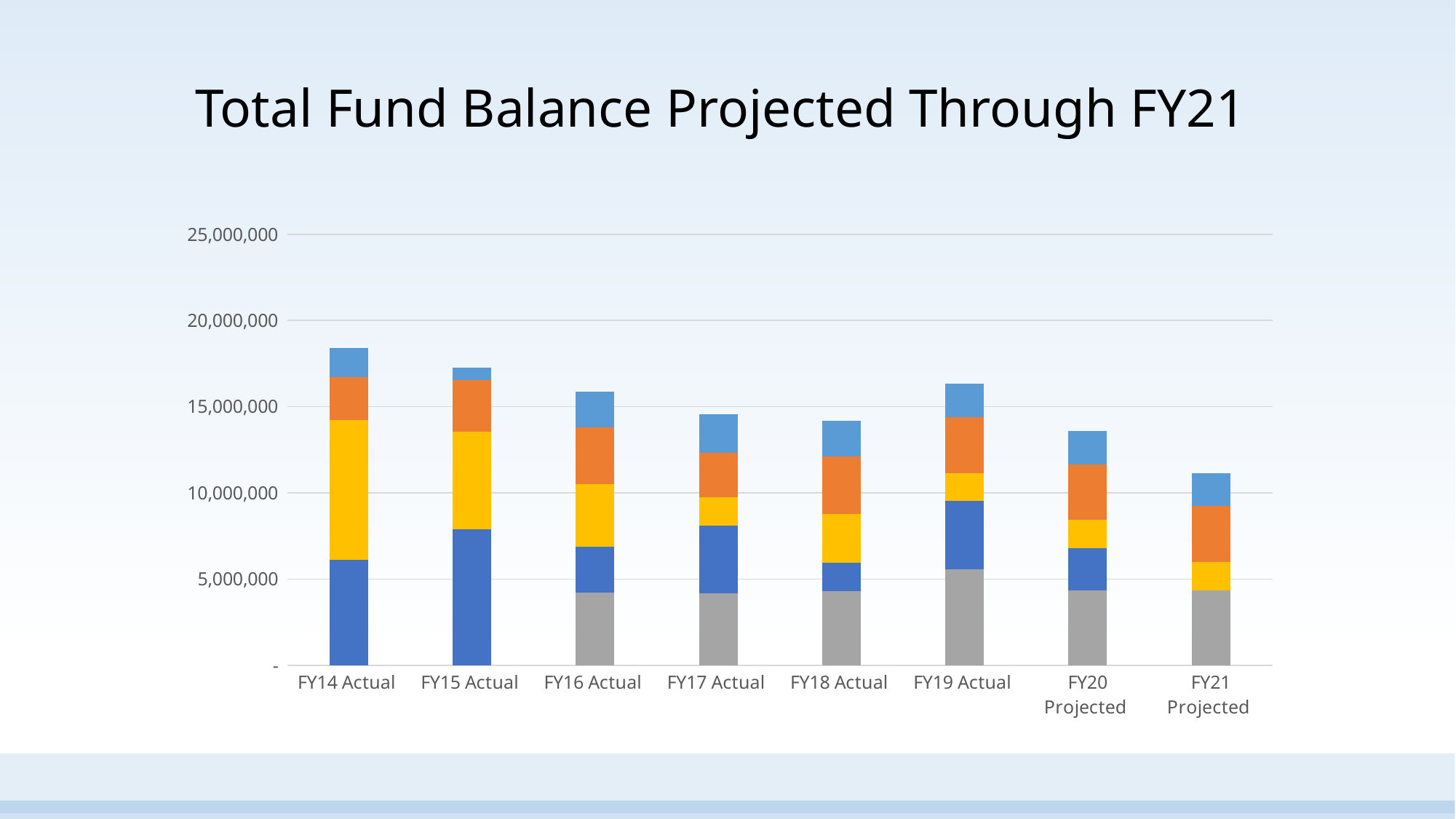
Is the total fund balance for FY21 Projected greater or less than 15,000,000? less Which has the larger total fund balance, FY19 Actual or FY18 Actual? FY19 Actual Is the total fund balance for FY18 Actual greater or less than 10,000,000? greater Is the total fund balance for FY20 Projected greater or less than 15,000,000? less Which fiscal year has the lowest total fund balance? FY21 Projected What is the title of the chart? Total Fund Balance Projected Through FY21 How many fiscal-year categories are shown on the x axis? 8 Which fiscal year has the highest total fund balance? FY14 Actual What kind of chart is shown on the slide? stacked bar chart Overall, does the total fund balance rise or fall from FY14 Actual to FY21 Projected? fall